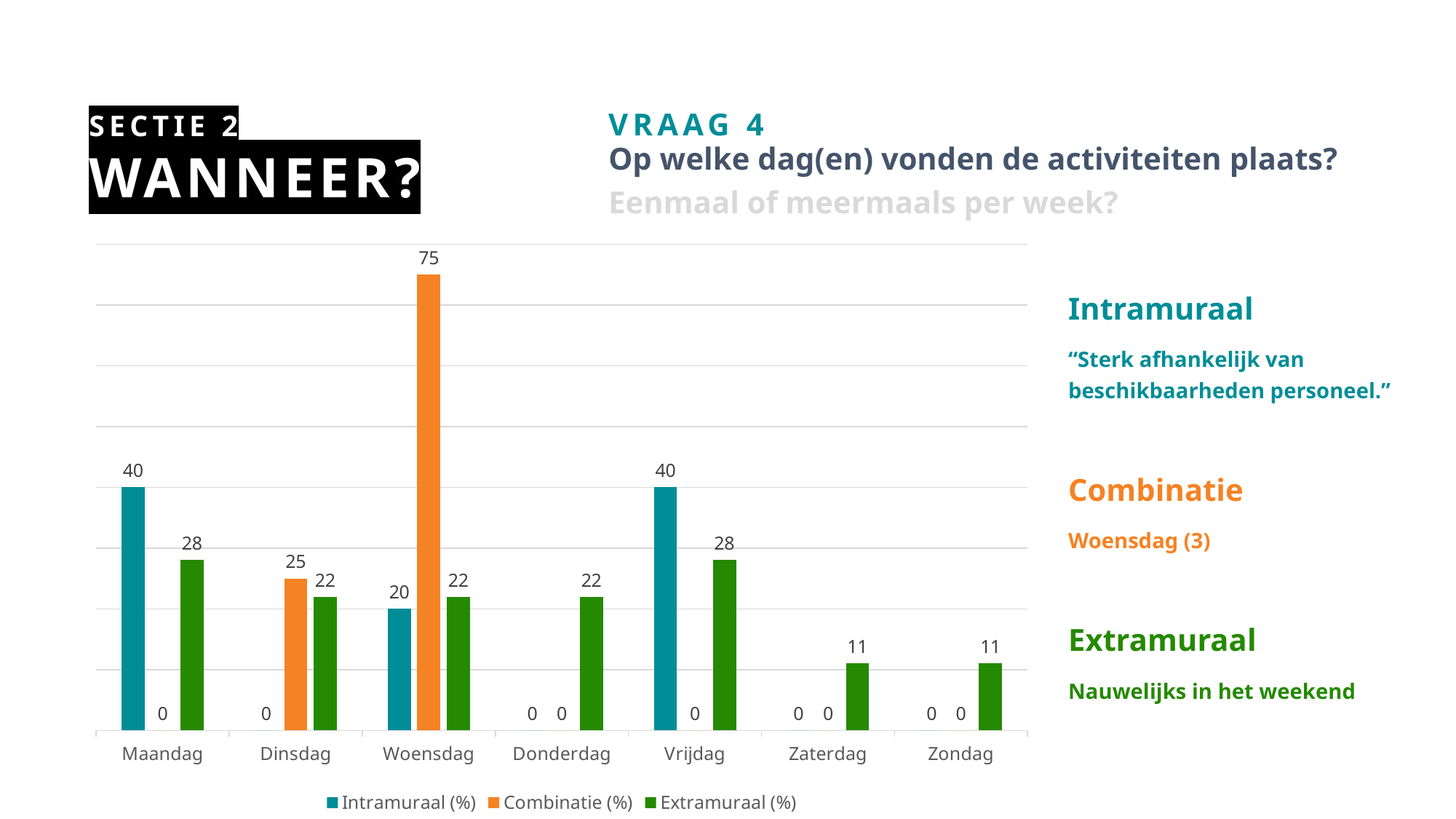
On which day is the Combinatie (%) value highest? Woensdag What is the difference between the Combinatie (%) value and the Intramuraal (%) value for Woensdag? 55 What is the Combinatie (%) value for Woensdag? 75 Which is larger for Maandag: the Intramuraal (%) value or the Extramuraal (%) value? Intramuraal (%) What kind of chart is shown on the slide? Bar chart What is the Combinatie (%) value for Dinsdag? 25 How many series does the chart legend list? 3 How many days are shown on the x axis of the chart? 7 What is the Intramuraal (%) value for Vrijdag? 40 What is the Extramuraal (%) value for Zaterdag? 11 On which day is the Extramuraal (%) value lowest? Zaterdag and Zondag Which colour represents the Combinatie (%) series in the chart? Orange